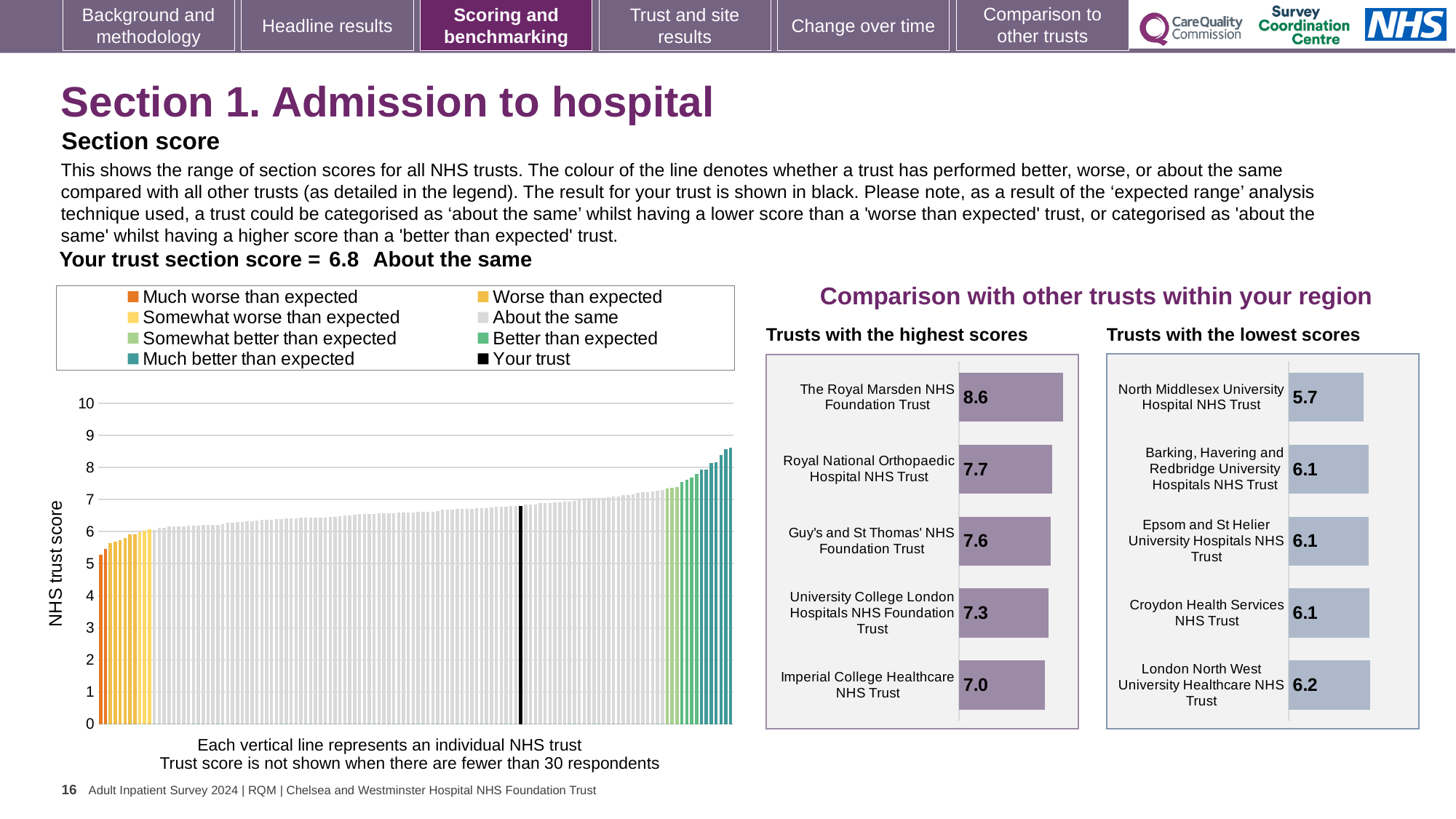
What kind of chart is the main 'NHS trust score' chart on the left of the slide? bar chart In the 'Trusts with the lowest scores' chart, which trust has the lowest score? North Middlesex University Hospital NHS Trust In the main 'NHS trust score' chart, do the trust scores rise or fall from left to right? rise How many entries does the legend of the main 'NHS trust score' chart list? 8 In the main 'NHS trust score' chart, what is the section score for your trust (shown in black)? 6.8 In the 'Trusts with the lowest scores' chart, what is the score for North Middlesex University Hospital NHS Trust? 5.7 In the 'Trusts with the highest scores' chart, which has the higher score: Guy's and St Thomas' NHS Foundation Trust or University College London Hospitals NHS Foundation Trust? Guy's and St Thomas' NHS Foundation Trust In the 'Trusts with the highest scores' chart, which trust has the highest score? The Royal Marsden NHS Foundation Trust In the 'Trusts with the highest scores' chart, what is the score for The Royal Marsden NHS Foundation Trust? 8.6 In the 'Trusts with the lowest scores' chart, what is the difference between the scores of London North West University Healthcare NHS Trust and North Middlesex University Hospital NHS Trust? 0.5 How many trusts are shown in the 'Trusts with the highest scores' chart? 5 In the 'Trusts with the highest scores' chart, what is the difference between the scores of The Royal Marsden NHS Foundation Trust and Imperial College Healthcare NHS Trust? 1.6